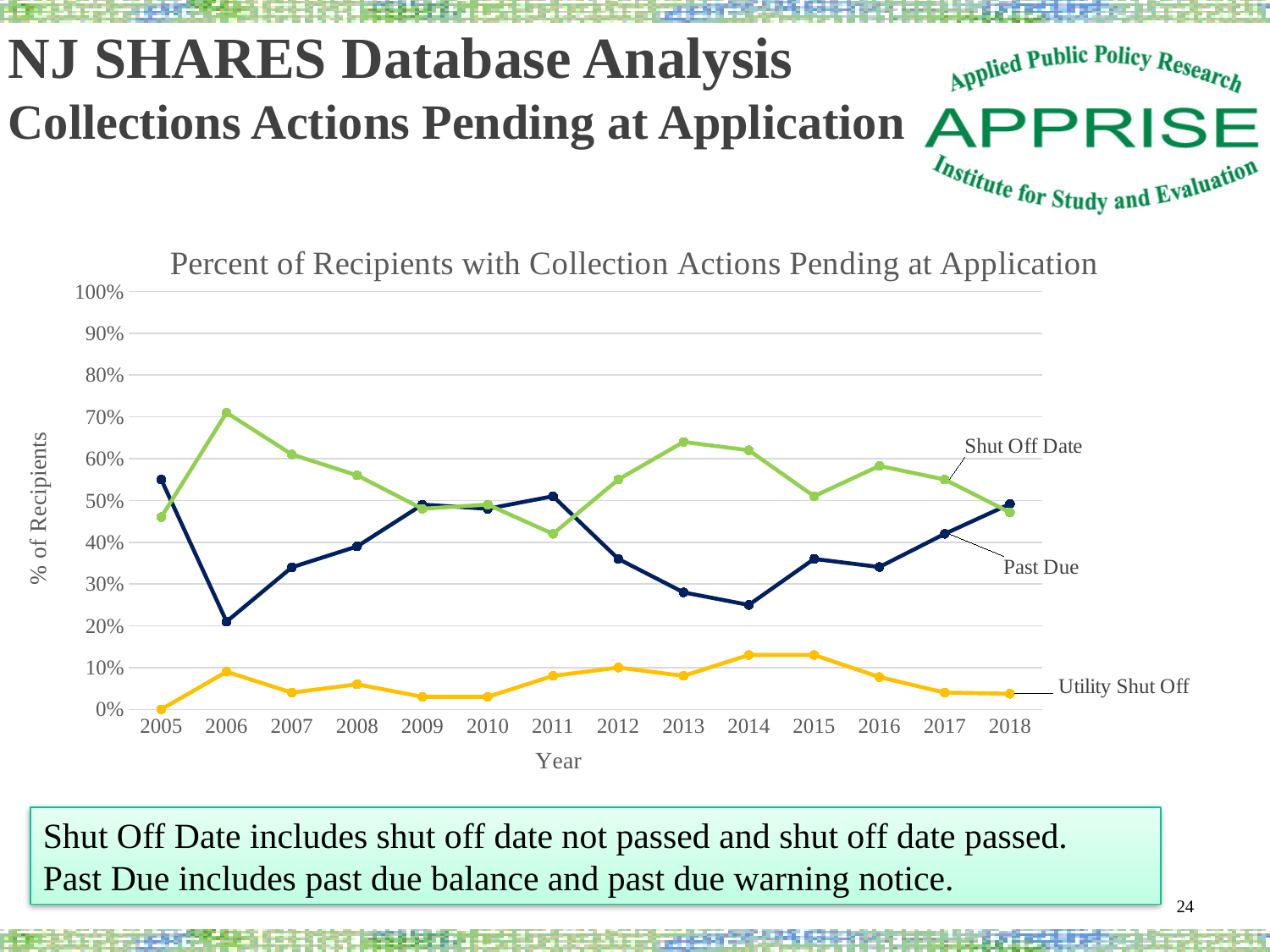
What kind of chart is shown on the slide? line chart In which year is the Shut Off Date series at its highest? 2006 Is the value for Shut Off Date in 2006 greater or less than 60%? greater In 2013, which series has the higher value, Shut Off Date or Past Due? Shut Off Date Does the Past Due series rise or fall from 2014 to 2018? rise Is the value for Past Due in 2014 greater or less than 30%? less How many years are shown along the x axis of the chart? 14 What is the value for Utility Shut Off in 2005? 0% In which year is the Past Due series at its lowest? 2006 In 2005, which series has the higher value, Past Due or Shut Off Date? Past Due Is the value for Utility Shut Off in 2015 greater or less than 20%? less How many data series are plotted on the chart? 3